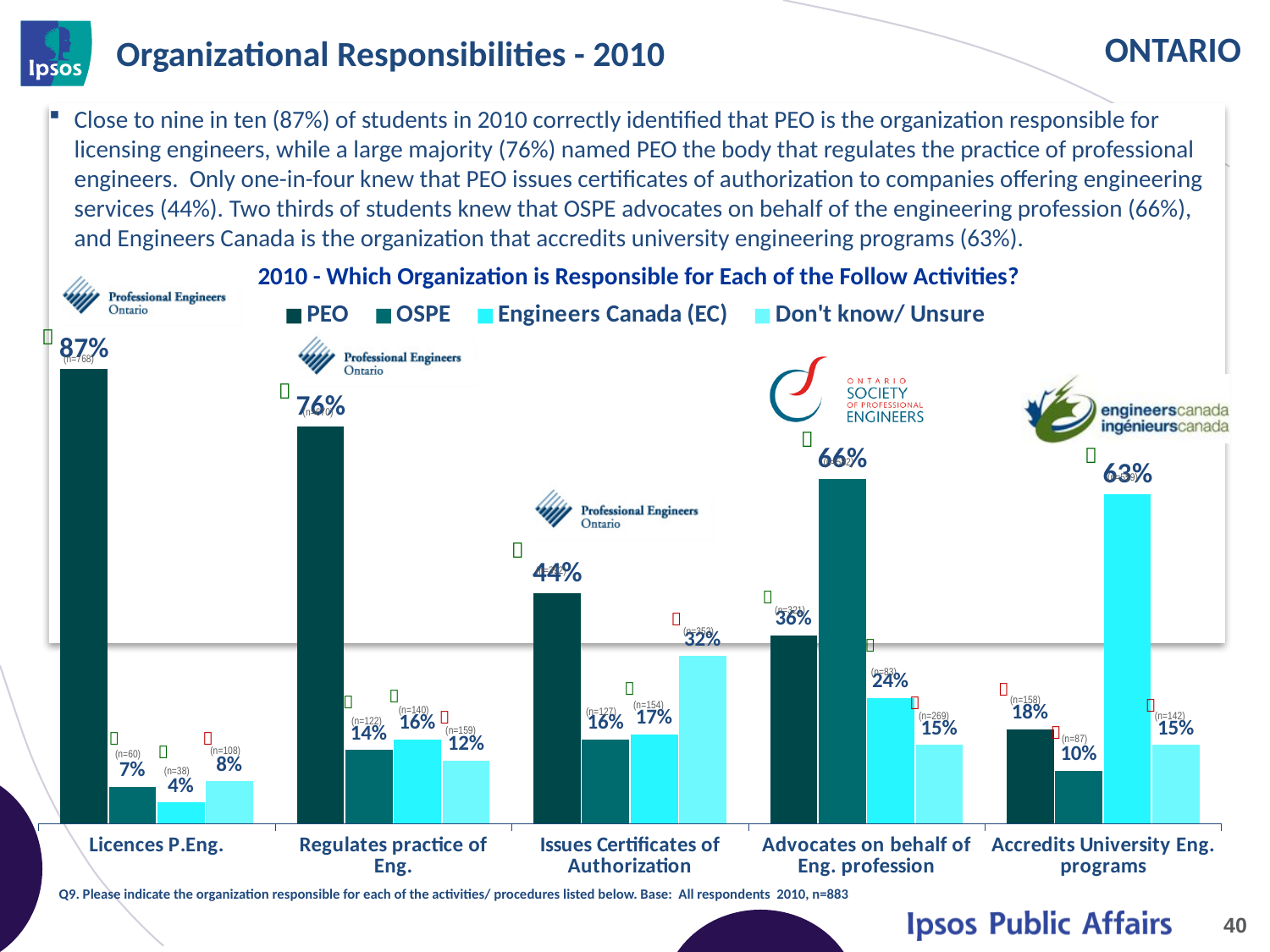
How many activity categories are shown on the x axis? 5 How many series does the legend list? 4 What percentage of students identified PEO as responsible for Licences P.Eng.? 87% What is the difference between the PEO value for 'Licences P.Eng.' and the PEO value for 'Regulates practice of Eng.'? 11% Which category has the highest PEO value? Licences P.Eng. Which category has the lowest Engineers Canada (EC) value? Licences P.Eng. What type of chart is shown on the slide? Bar chart What is the title of the chart? 2010 - Which Organization is Responsible for Each of the Follow Activities? What is the 'Don't know/ Unsure' value for 'Issues Certificates of Authorization'? 32% In the 'Advocates on behalf of Eng. profession' category, which is larger: the PEO value or the OSPE value? OSPE What is the value for OSPE in the 'Advocates on behalf of Eng. profession' category? 66% What is the value for Engineers Canada (EC) in the 'Accredits University Eng. programs' category? 63%